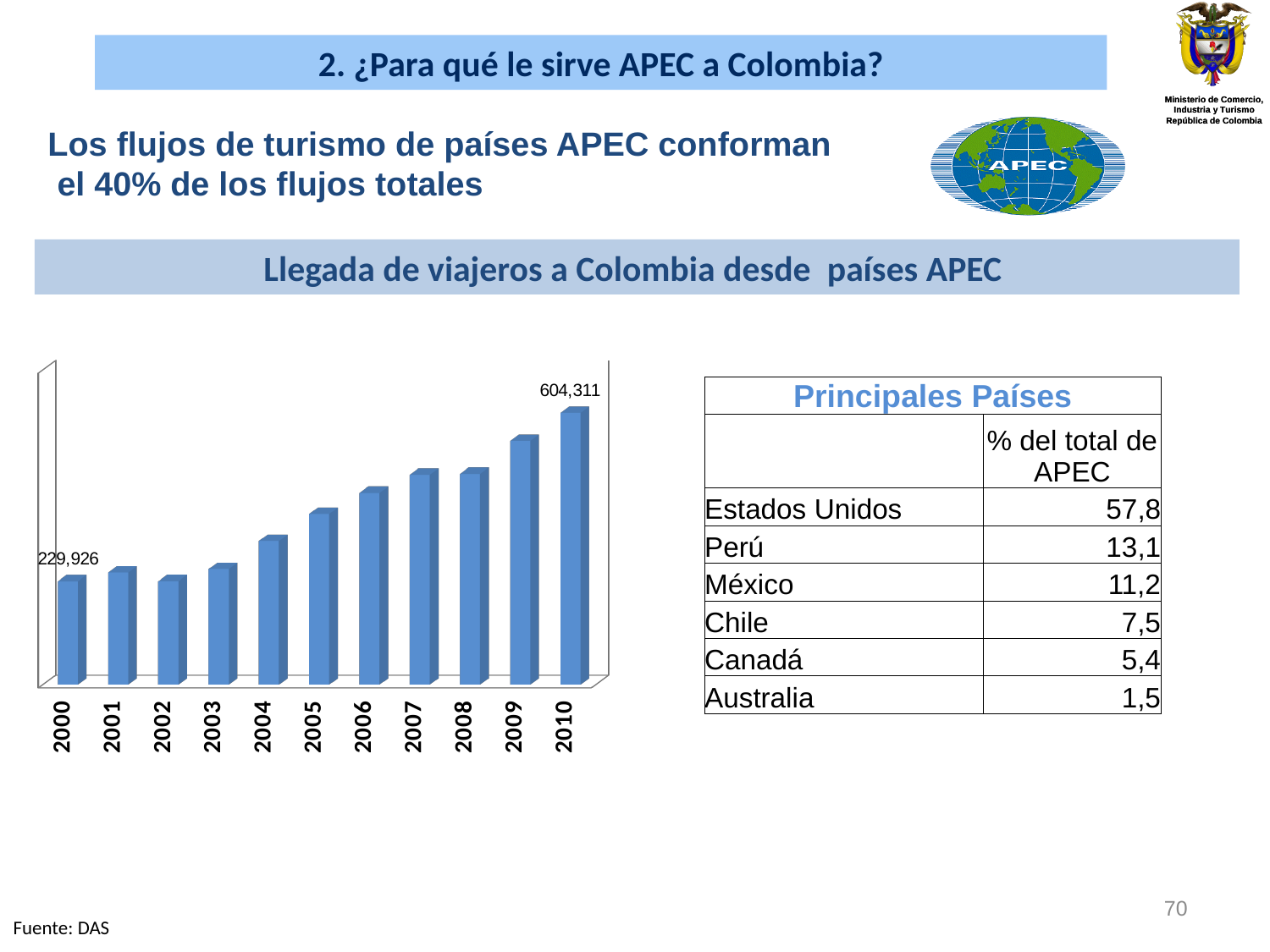
What is the title of the chart on the slide? Llegada de viajeros a Colombia desde países APEC What is the value shown for 2010 in the bar chart? 604,311 How many years are shown on the x axis of the bar chart? 11 Which is larger in the bar chart, the value for 2006 or the value for 2003? 2006 Which is larger in the bar chart, the value for 2010 or the value for 2000? 2010 What is the value shown for 2000 in the bar chart? 229,926 What is the difference between the 2010 value and the 2000 value in the bar chart? 374,385 What kind of chart is used to show arrivals of travellers to Colombia from APEC countries? Bar chart Do the values in the bar chart generally rise or fall from 2000 to 2010? Rise Which year has the highest bar in the chart? 2010 What source is cited for the chart on the slide? DAS Which is larger in the bar chart, the value for 2009 or the value for 2004? 2009